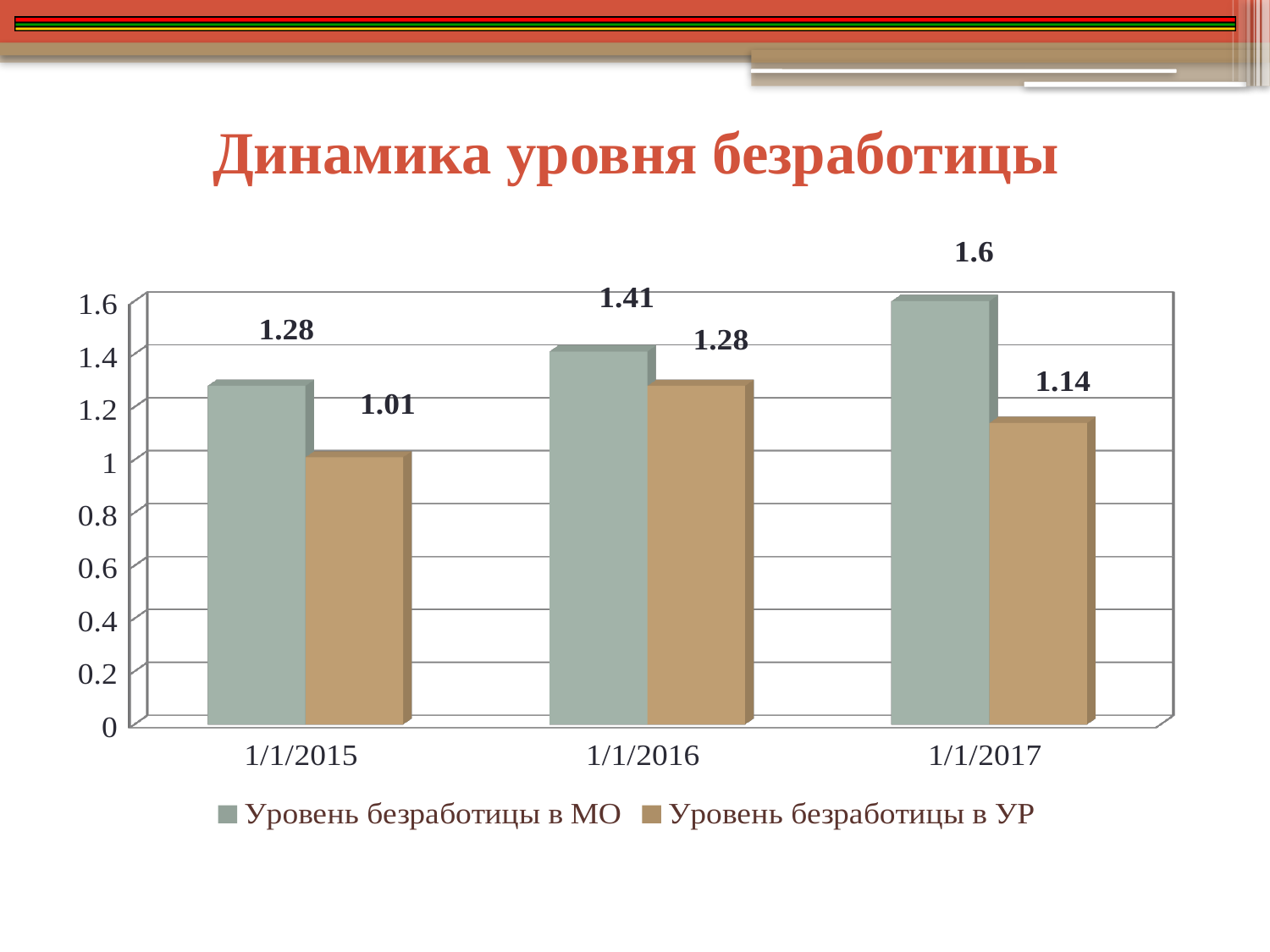
Does Уровень безработицы в МО rise or fall from 1/1/2015 to 1/1/2017? Rise What kind of chart is shown on the slide? Bar chart How many series does the legend list? 2 How many dates are shown on the x axis? 3 For which date is Уровень безработицы в МО highest? 1/1/2017 What is the value of Уровень безработицы в УР for 1/1/2015? 1.01 For which date is Уровень безработицы в УР lowest? 1/1/2015 What is the difference between Уровень безработицы в МО and Уровень безработицы в УР for 1/1/2017? 0.46 What is the value of Уровень безработицы в МО for 1/1/2017? 1.6 What is the value of Уровень безработицы в УР for 1/1/2016? 1.28 Which is larger for 1/1/2016: Уровень безработицы в МО or Уровень безработицы в УР? Уровень безработицы в МО What is the value of Уровень безработицы в МО for 1/1/2015? 1.28